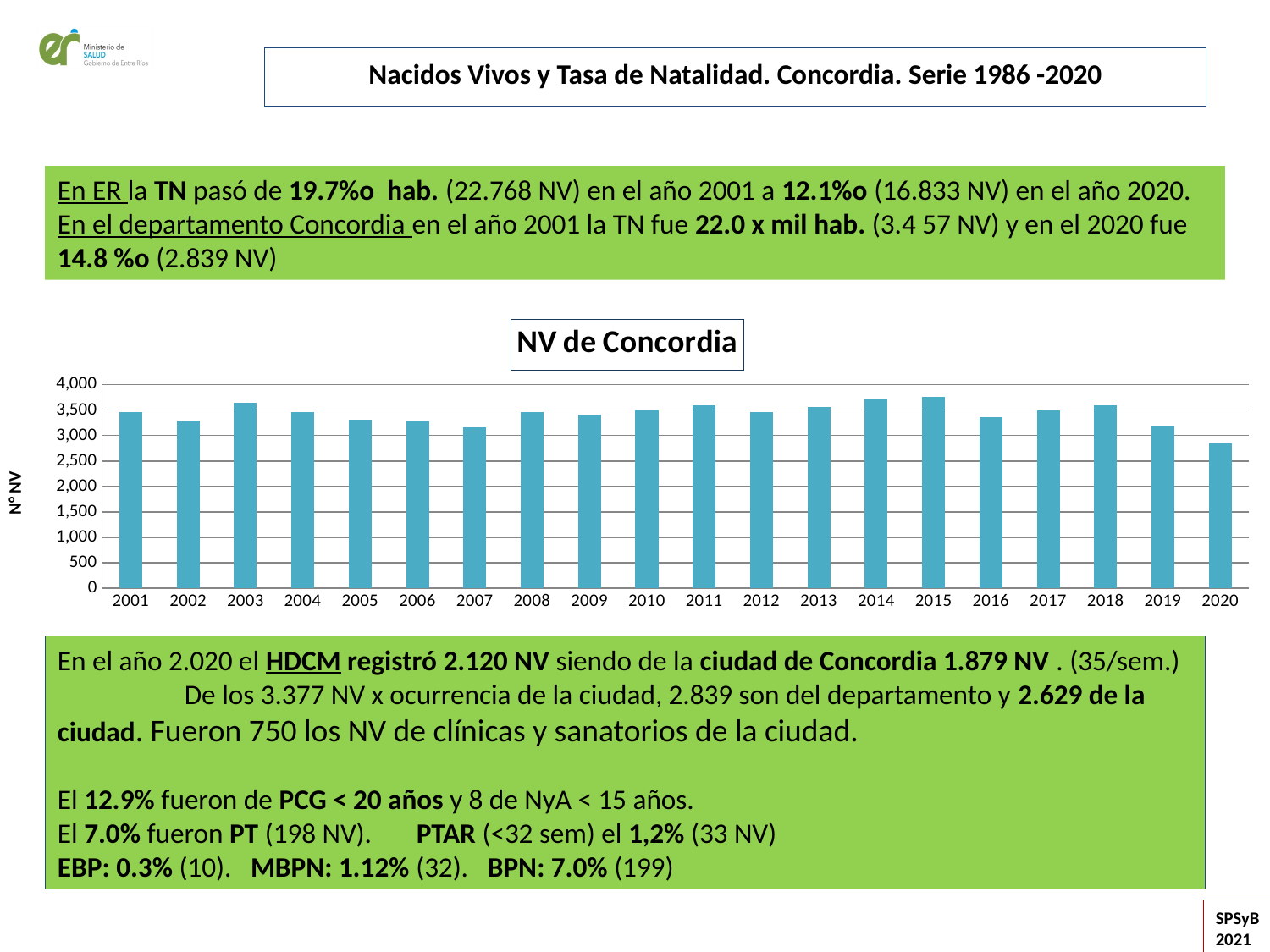
On the 'NV de Concordia' chart, which year has more NV, 2019 or 2020? 2019 On the 'NV de Concordia' chart, do the values rise or fall from 2015 to 2020? fall What is the label on the vertical axis of the 'NV de Concordia' chart? N° NV Is the value for 2015 on the 'NV de Concordia' chart greater or less than 3,500? greater How many years are plotted on the 'NV de Concordia' chart? 20 On the 'NV de Concordia' chart, which year has more NV, 2002 or 2003? 2003 Is the value for 2002 on the 'NV de Concordia' chart greater or less than 3,500? less What kind of chart is the 'NV de Concordia' chart? bar chart Which year has the highest number of NV on the 'NV de Concordia' chart? 2015 Is the value for 2020 on the 'NV de Concordia' chart greater or less than 3,000? less Which year has the lowest number of NV on the 'NV de Concordia' chart? 2020